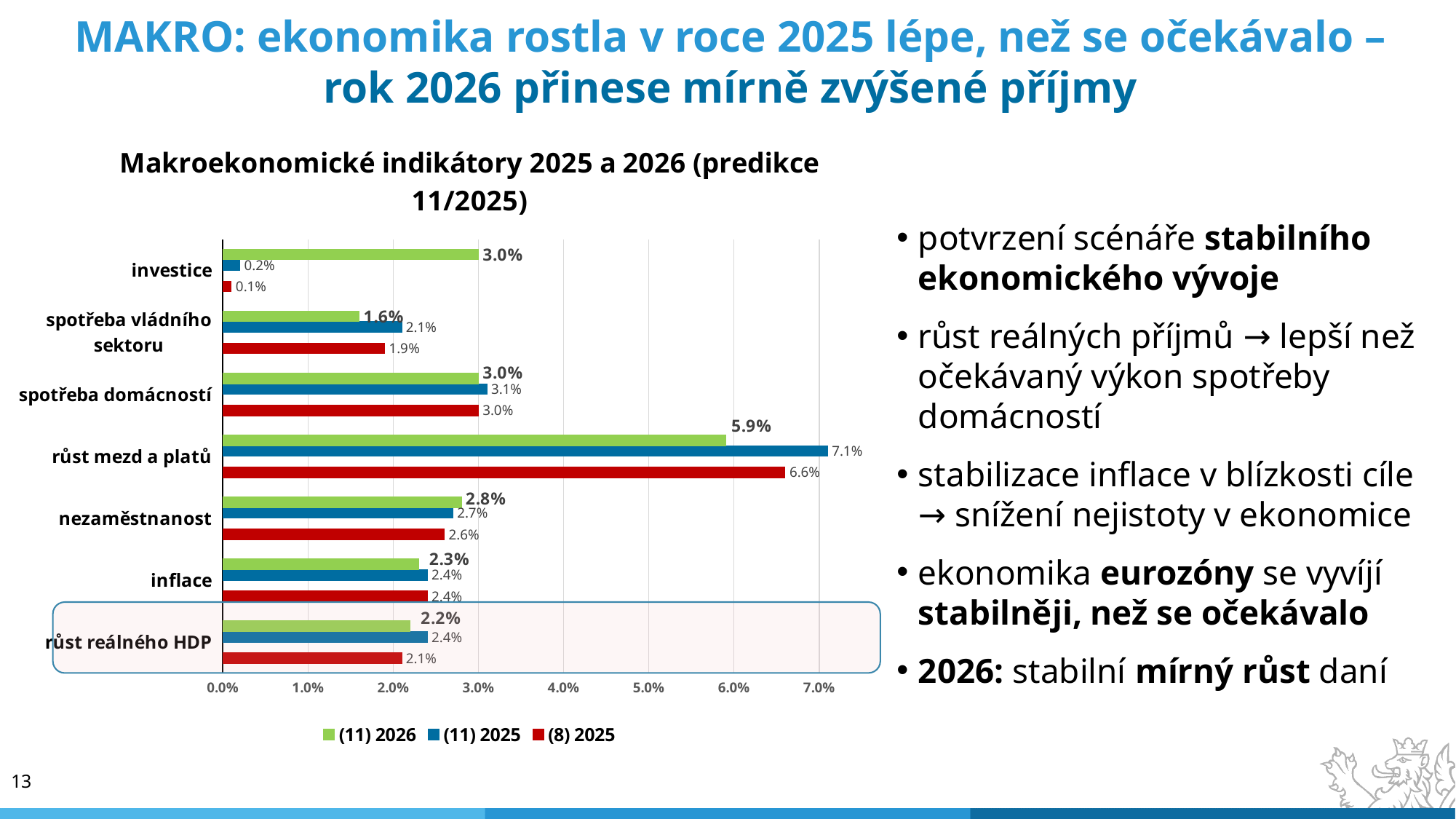
What is the title of the chart? Makroekonomické indikátory 2025 a 2026 (predikce 11/2025) How many series does the chart legend list? 3 What is the difference between the (11) 2026 and (8) 2025 values for investice? 2.9% How many categories are shown on the chart? 7 Which category has the lowest (8) 2025 value? investice What is the (11) 2025 value for investice? 0.2% Which category has the highest (11) 2025 value? růst mezd a platů What is the (8) 2025 value for růst reálného HDP? 2.1% What kind of chart is shown on the slide? bar chart What is the difference between the (11) 2025 and (11) 2026 values for růst mezd a platů? 1.2% Which is larger for spotřeba vládního sektoru: the (11) 2026 value or the (11) 2025 value? (11) 2025 What is the (11) 2026 value for růst mezd a platů? 5.9%